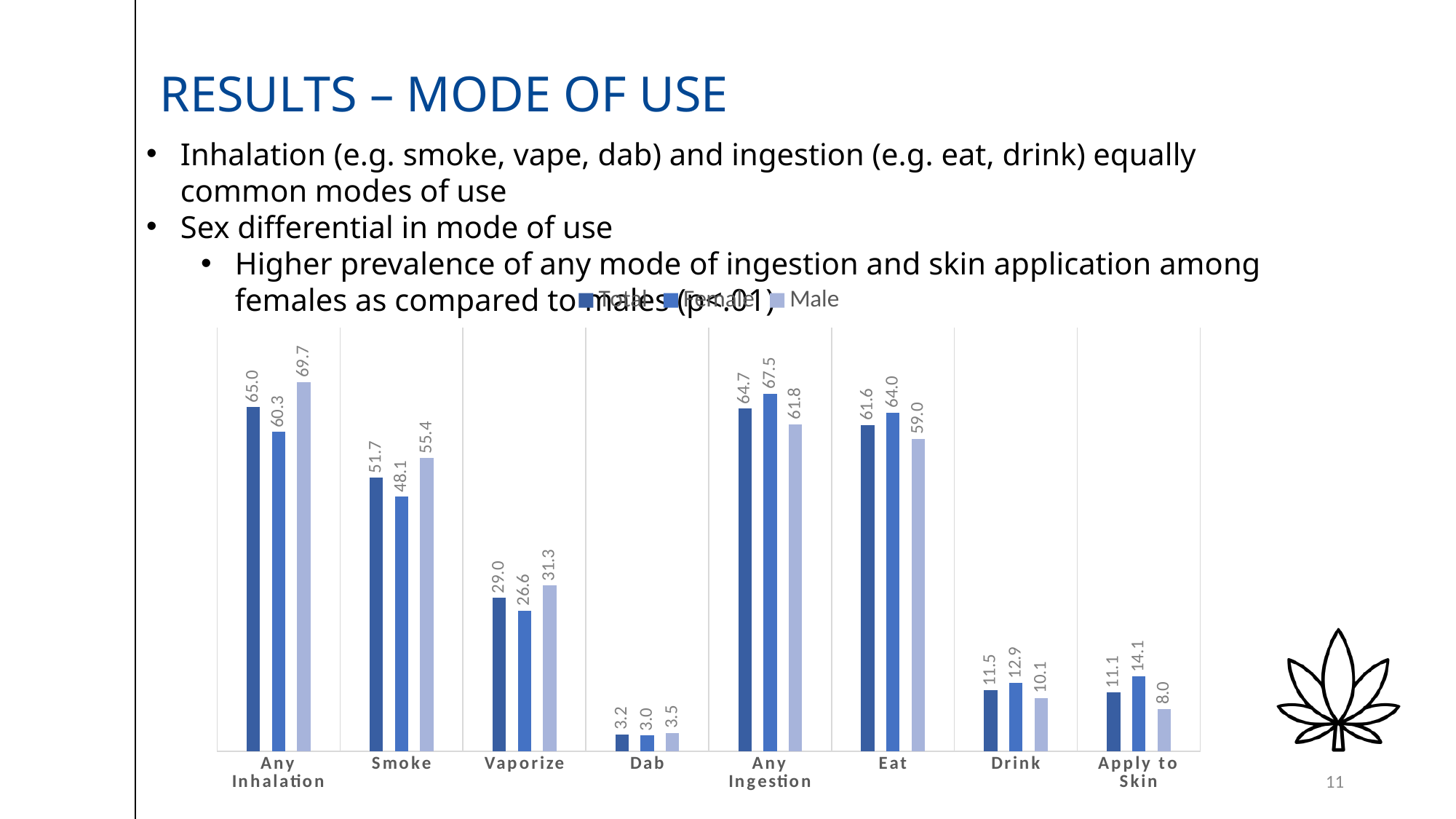
What is the difference between the Male and Female values for Any Inhalation? 9.4 Which category has the lowest Total value? Dab For Any Ingestion, which is larger, the Female value or the Male value? Female What is the Female value for Apply to Skin? 14.1 For Smoke, which is larger, the Female value or the Male value? Male What is the Male value for Any Inhalation? 69.7 How many series does the legend list? 3 What kind of chart is shown on the slide? Bar chart How many categories are shown on the x axis? 8 Which category has the highest Male value? Any Inhalation What is the Total value for Vaporize? 29.0 What is the difference between the Female and Male values for Apply to Skin? 6.1